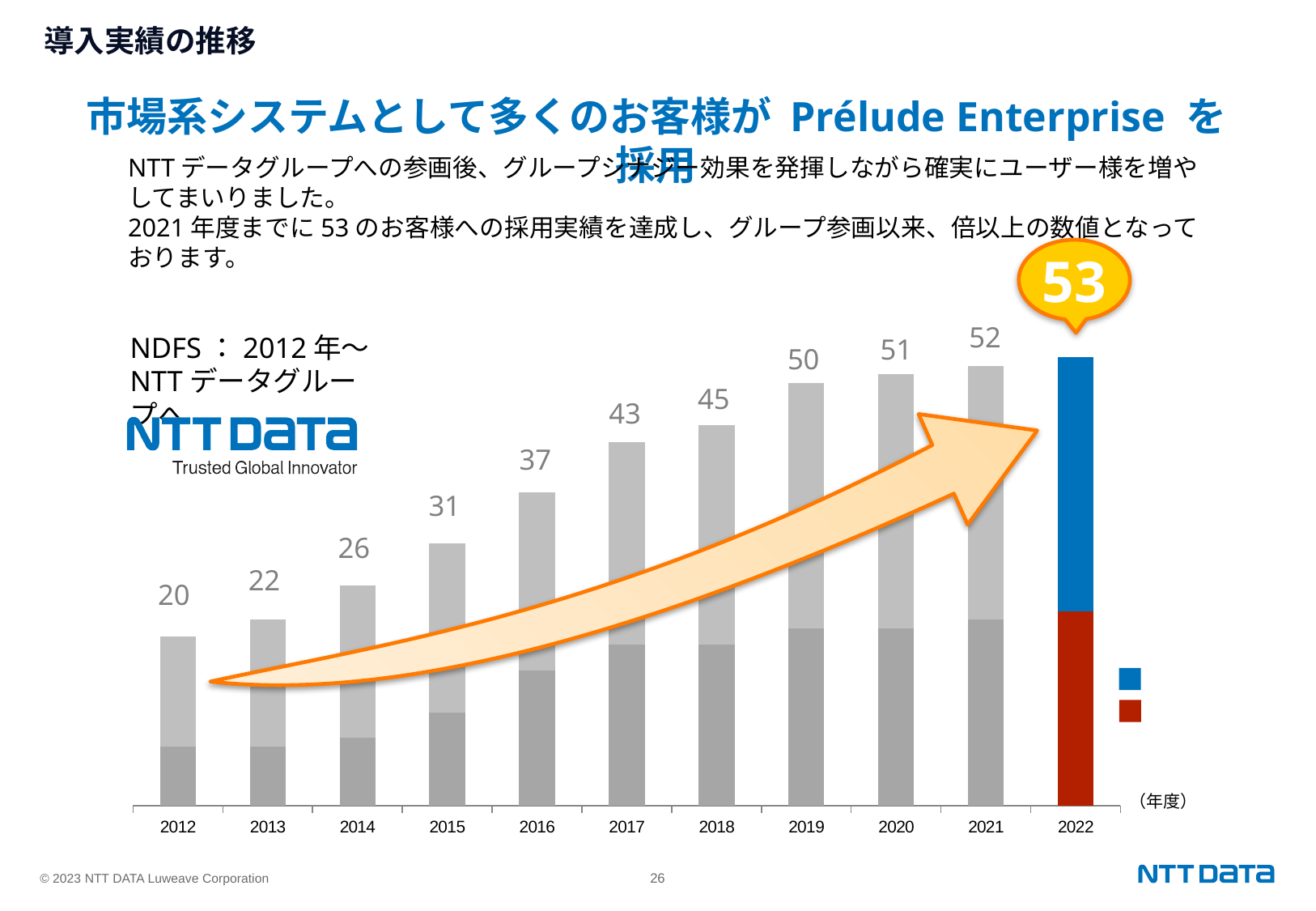
How many years are shown on the x axis? 11 Which is larger, the total for 2015 or the total for 2018? 2018 Which year has the highest total value? 2022 What is the total value shown for 2019? 50 What is the difference between the total for 2017 and the total for 2016? 6 What is the total value shown for 2016? 37 What is the difference between the total for 2022 and the total for 2012? 33 What is the total of the stacked bar for 2022? 53 Which year has the lowest total value? 2012 Do the total values rise or fall from 2012 to 2022? rise What is the total value shown for 2012? 20 What is the total value shown for 2021? 52